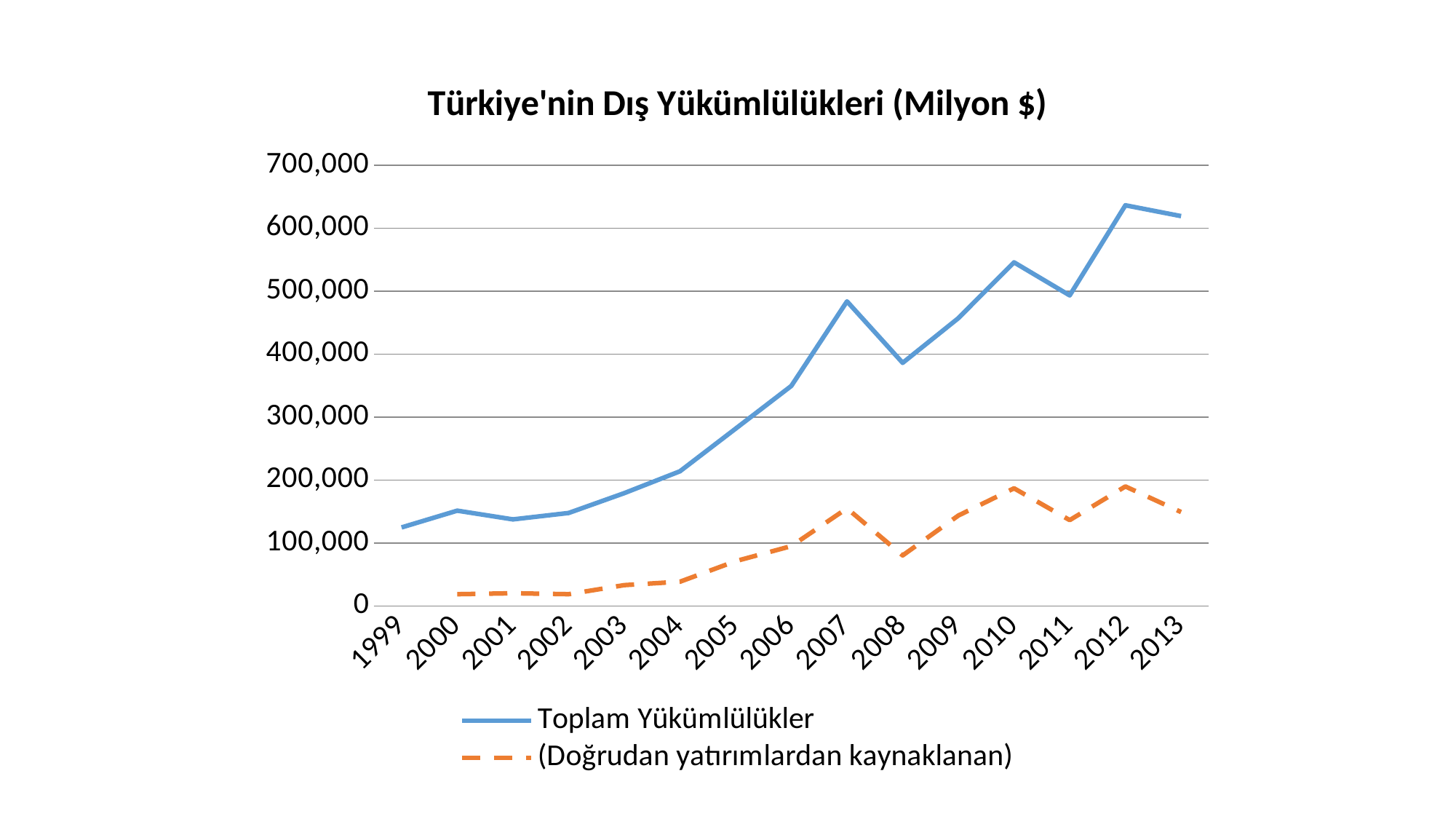
How many series does the legend list? 2 Does Toplam Yükümlülükler generally rise or fall from 1999 to 2013? Rise How many years are shown on the x axis? 15 Is the value of Toplam Yükümlülükler in 2012 greater or less than 600,000? greater Is the value of Toplam Yükümlülükler in 2007 greater or less than 400,000? greater Is the value of (Doğrudan yatırımlardan kaynaklanan) in 2003 greater or less than 100,000? less For Toplam Yükümlülükler, which year has the larger value, 2007 or 2008? 2007 Which series is drawn with a dashed orange line? (Doğrudan yatırımlardan kaynaklanan) What kind of chart is shown on the slide? Line chart What is the title of the chart? Türkiye'nin Dış Yükümlülükleri (Milyon $)